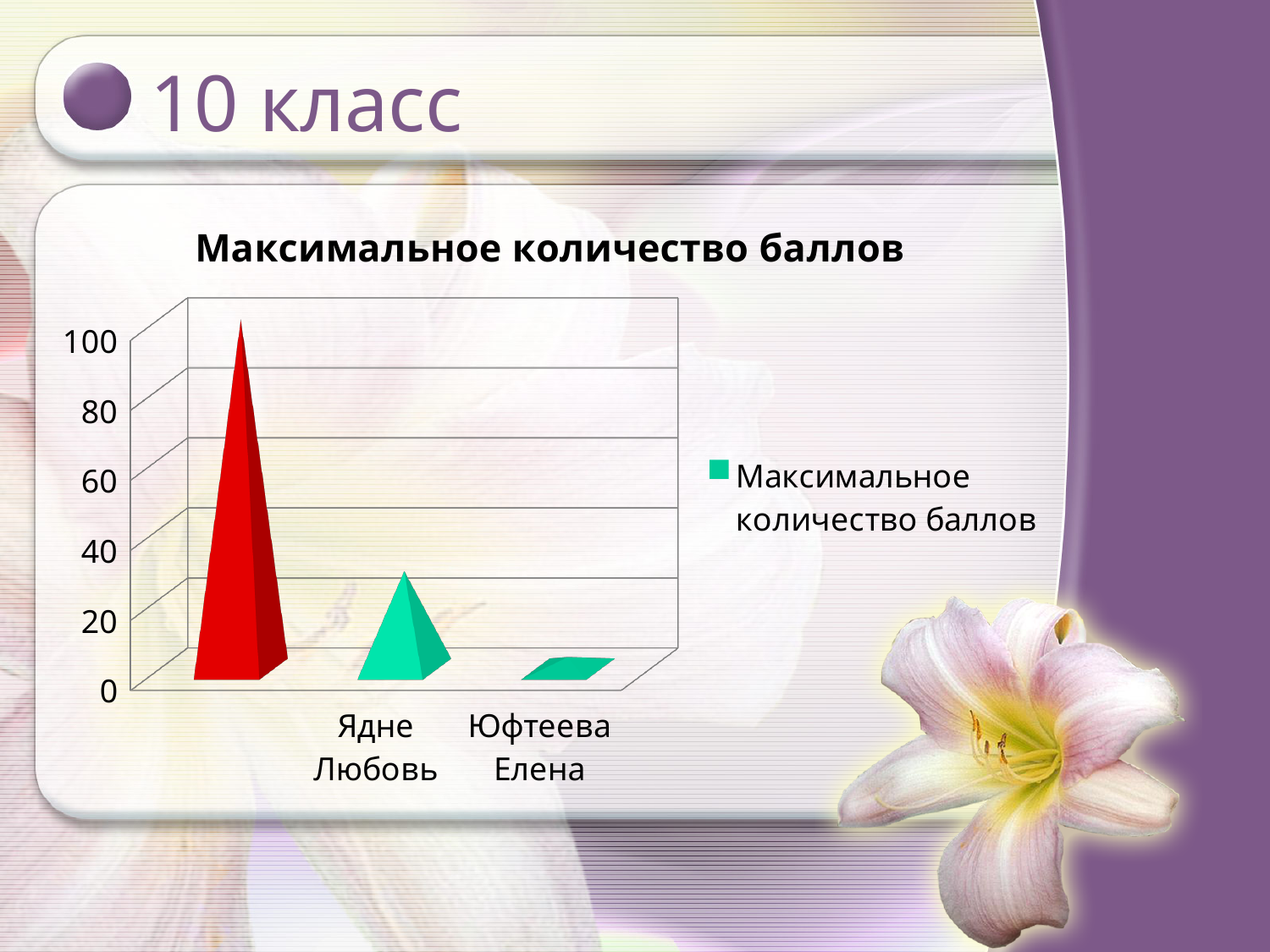
What is the legend entry shown next to the chart? Максимальное количество баллов How many bars are plotted in the chart? 3 What kind of chart is shown on the slide? bar chart Is the value for Ядне Любовь greater or less than 20? greater Which labelled category has the lowest value? Юфтеева Елена How many series does the legend list? 1 Is the value for Юфтеева Елена greater or less than 20? less Is the value for Ядне Любовь greater or less than 40? less What is the title of the chart? Максимальное количество баллов Which is larger, the value for Ядне Любовь or the value for Юфтеева Елена? Ядне Любовь What is the highest value shown on the vertical axis? 100